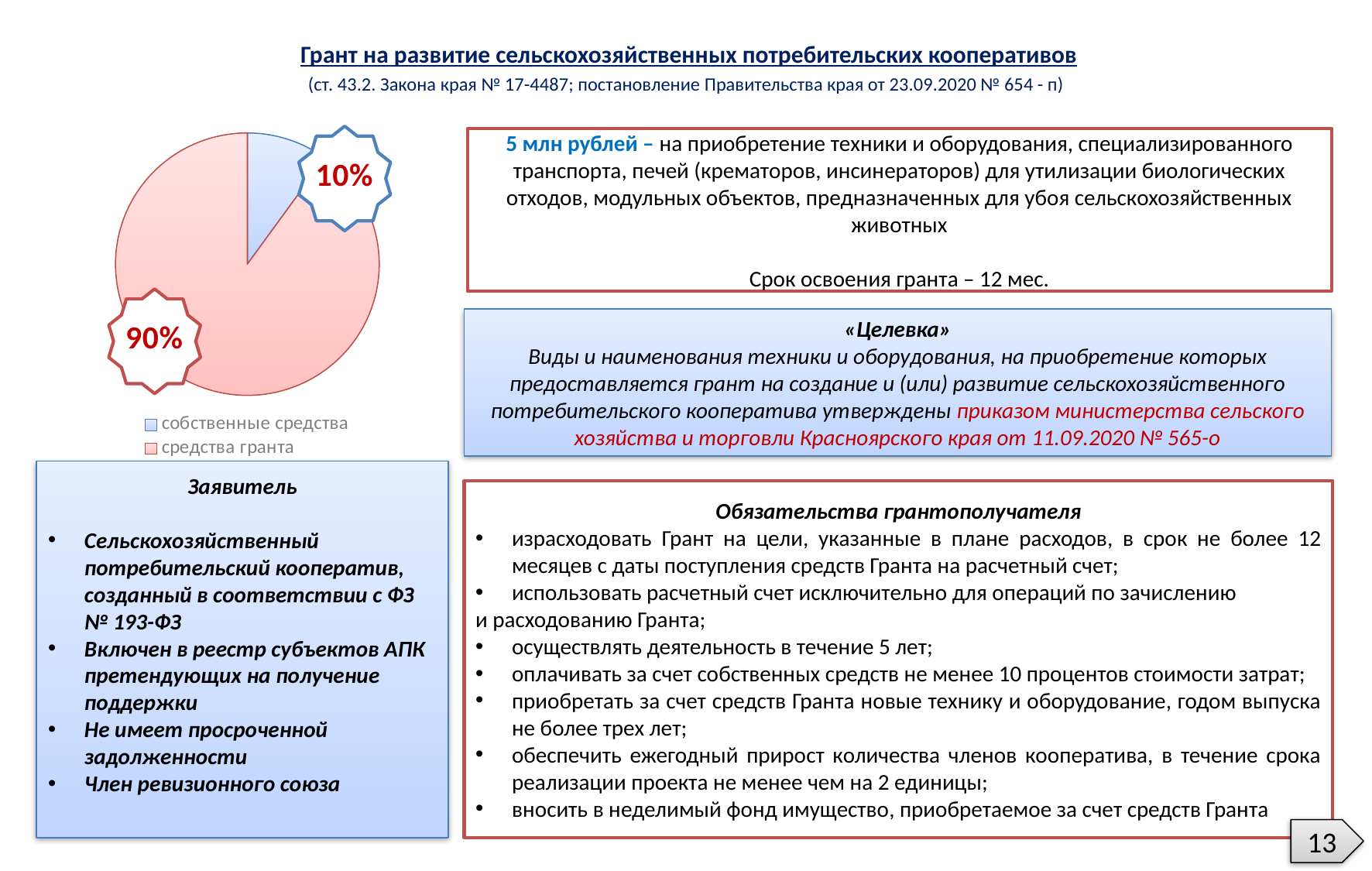
What kind of chart is shown on the slide? pie chart What share of the pie chart is labelled "собственные средства"? 10% By how many percentage points does "средства гранта" exceed "собственные средства" in the pie chart? 80 Which slice of the pie chart is the largest? средства гранта How many entries does the pie chart's legend list? 2 Which slice of the pie chart is the smallest? собственные средства What colour is the "собственные средства" slice in the pie chart? blue What colour is the "средства гранта" slice in the pie chart? pink What is the total of the two slices shown in the pie chart? 100% What share of the pie chart is labelled "средства гранта"? 90% How many slices does the pie chart have? 2 Which is larger in the pie chart: "собственные средства" or "средства гранта"? средства гранта